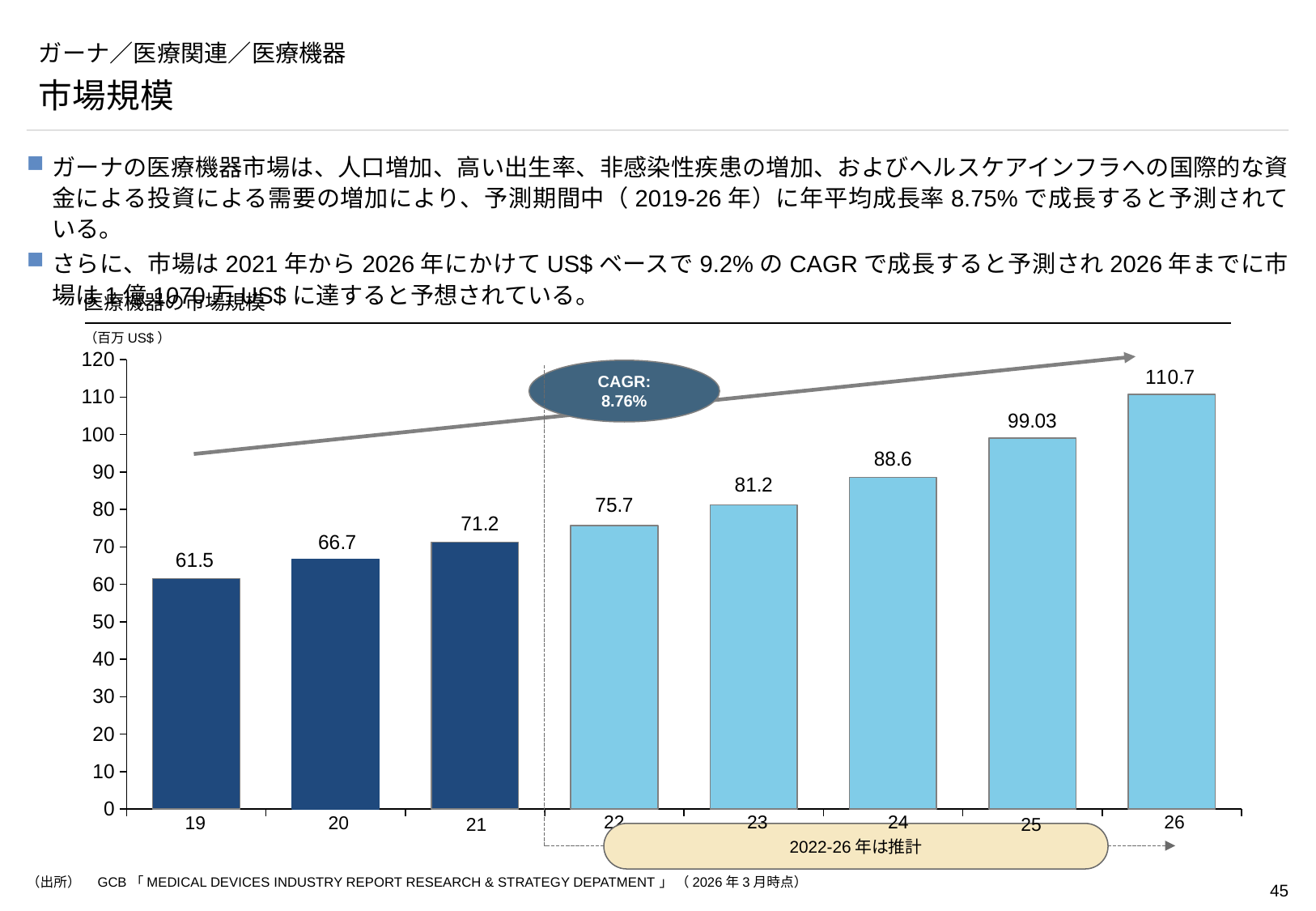
What is the difference between the values for 2022 and 2021? 4.5 Which year has the highest market size value? 26 What is the market size value shown for 2019 (19)? 61.5 What is the difference between the values for 2026 and 2019? 49.2 How many years (bars) are plotted in the chart? 8 Which year has the lowest market size value? 19 What CAGR is shown in the oval annotation on the chart? 8.76% What is the value shown for 2025 (25)? 99.03 What is the value shown for 2023 (23)? 81.2 Do the values rise or fall from 2019 to 2026? Rise Which is larger, the value for 2024 or the value for 2023? 2024 What kind of chart is shown on the slide? Bar chart